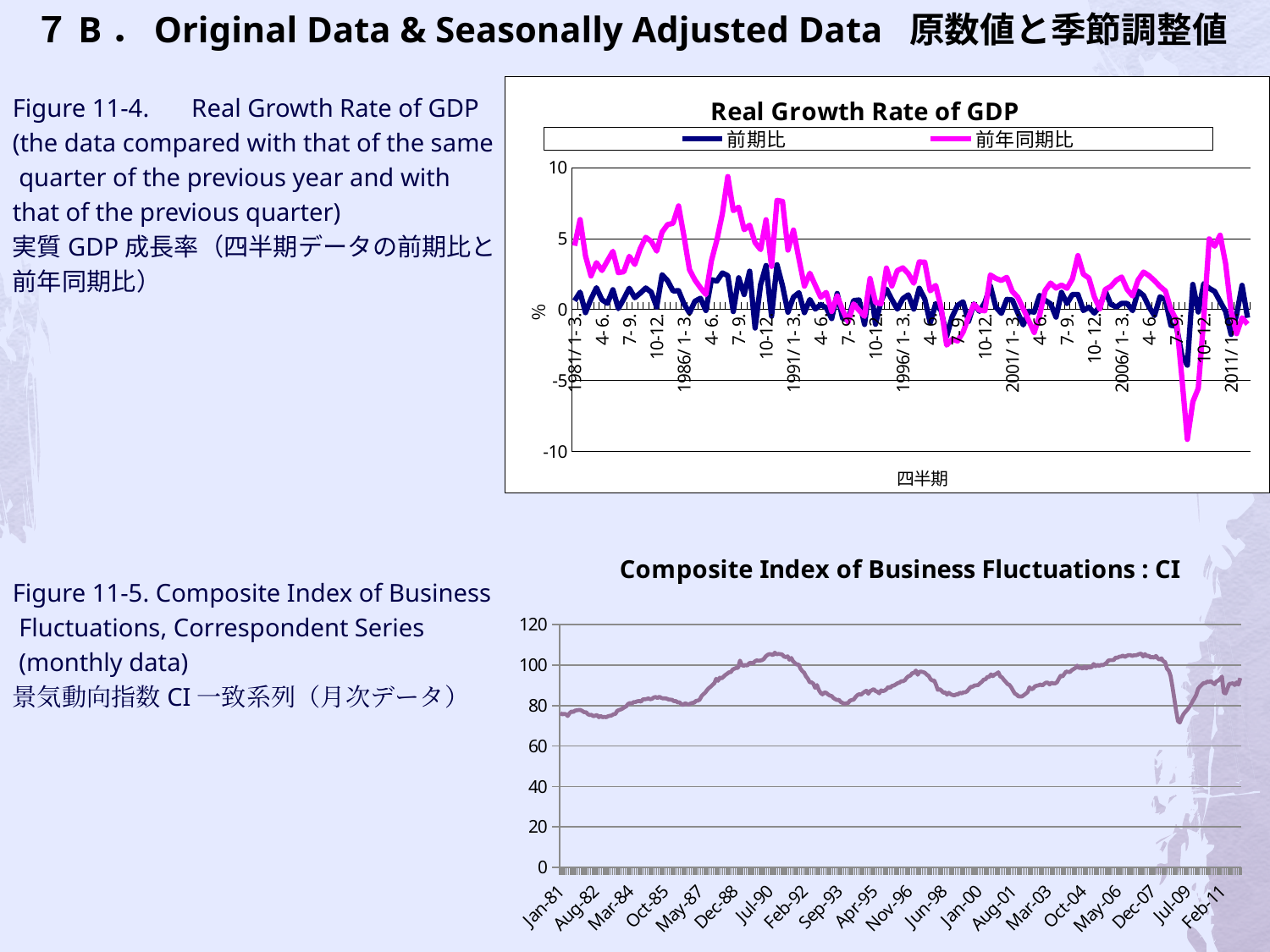
In the 'Composite Index of Business Fluctuations : CI' chart, is the peak value around Jul-90 greater or less than 100? greater In the 'Real Growth Rate of GDP' chart, which series reaches the higher peak, 前期比 or 前年同期比? 前年同期比 In the 'Composite Index of Business Fluctuations : CI' chart, is the value at Jan-81 greater or less than 80? less In the 'Composite Index of Business Fluctuations : CI' chart, is the lowest value around Jul-09 greater or less than 80? less In the 'Real Growth Rate of GDP' chart, what is the label on the horizontal axis? 四半期 What kind of chart is the 'Composite Index of Business Fluctuations : CI' chart? Line chart In the 'Real Growth Rate of GDP' chart, what are the two legend entries? 前期比 and 前年同期比 In the 'Composite Index of Business Fluctuations : CI' chart, does the index rise or fall between Jan-81 and Jul-90? rise How many series does the legend of the 'Real Growth Rate of GDP' chart list? 2 What kind of chart is the 'Real Growth Rate of GDP' chart? Line chart